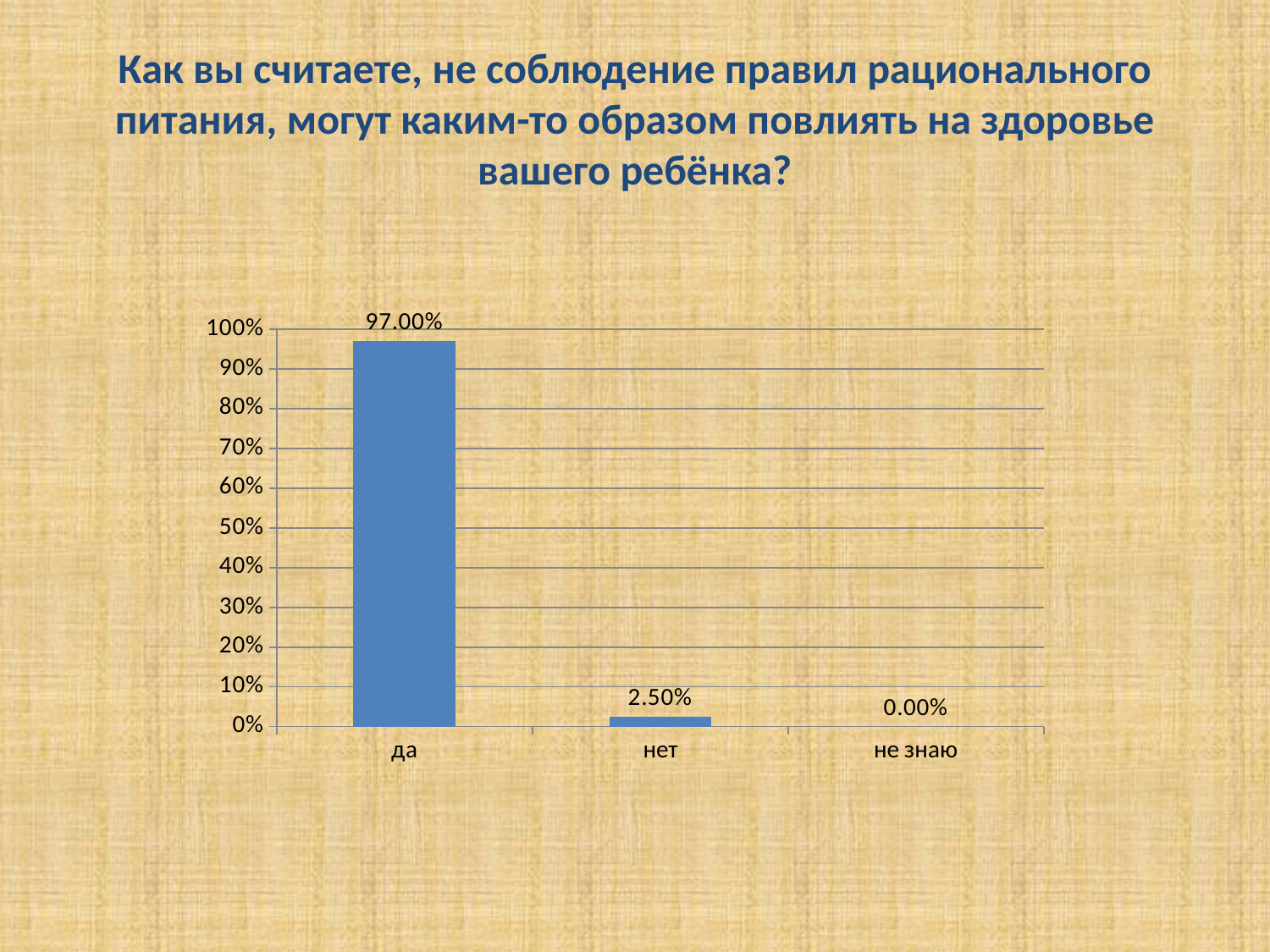
Do the values rise or fall from left to right along the x axis? fall Is the value for "да" greater or less than 90%? greater Is the value for "нет" greater or less than 10%? less How many categories are shown on the x axis? 3 What is the difference between the values for "да" and "нет"? 94.50% What is the value for "да"? 97.00% Which is larger, the value for "нет" or the value for "не знаю"? нет What is the value for "нет"? 2.50% What kind of chart is shown on the slide? bar chart Which category has the highest value? да Which category has the lowest value? не знаю What is the value for "не знаю"? 0.00%